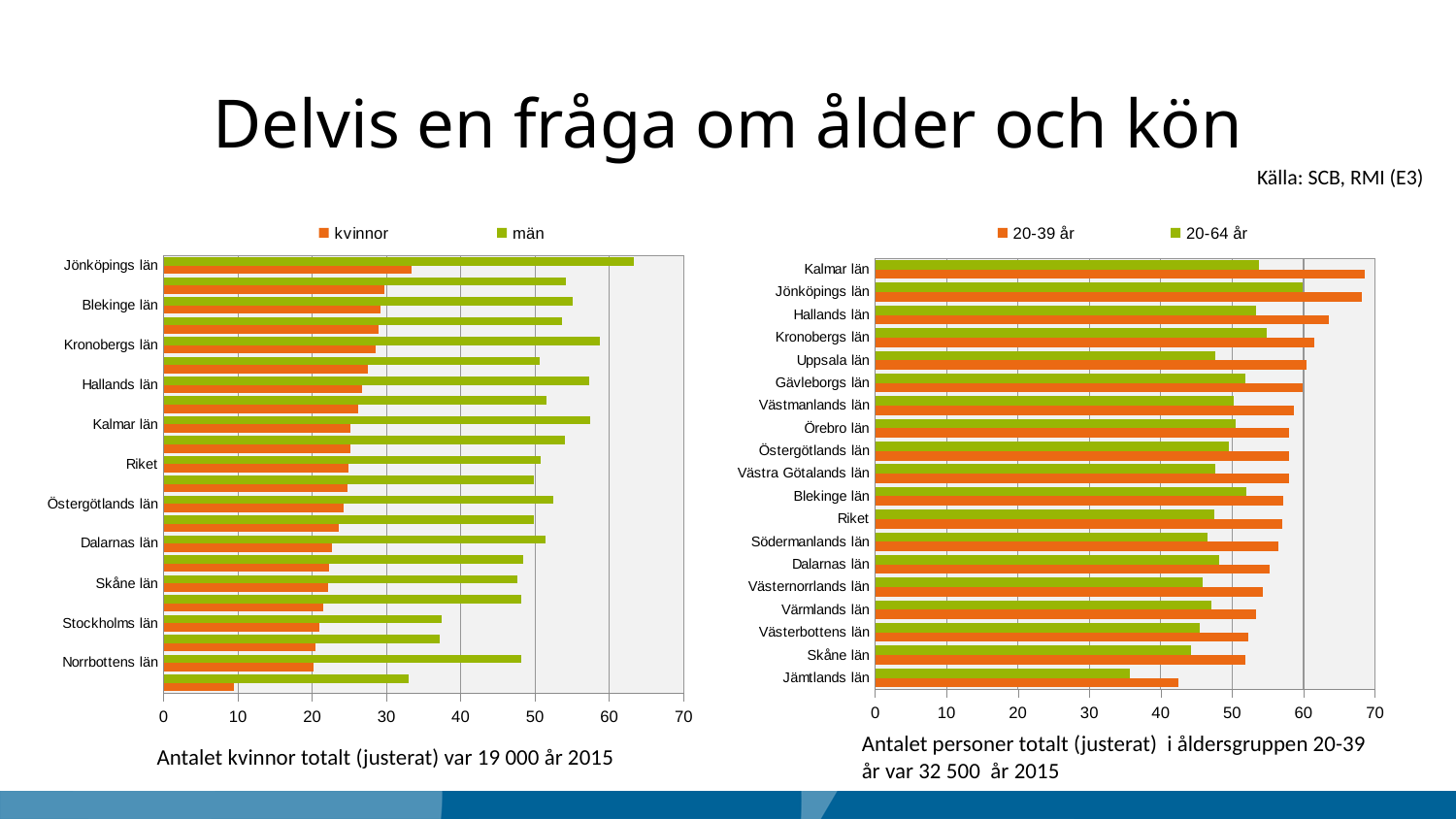
How many series does the legend of the left-hand chart list? 2 In the left-hand chart, which series has the larger value for Jönköpings län, kvinnor or män? män What kind of chart is the right-hand chart (20-39 år / 20-64 år)? bar chart In the right-hand chart, do the 20-39 år values rise or fall going from Kalmar län at the top to Jämtlands län at the bottom? fall In the right-hand chart, which series has the larger value for Kalmar län, 20-39 år or 20-64 år? 20-39 år How many categories (län/Riket) are shown on the right-hand chart? 19 In the left-hand chart, is the män value for Jönköpings län greater or less than 60? greater In the right-hand chart, which category has the lowest 20-64 år value? Jämtlands län In the right-hand chart, which category has the lowest 20-39 år value? Jämtlands län What are the two legend entries of the left-hand chart? kvinnor and män In the right-hand chart, is the 20-64 år value for Jämtlands län greater or less than 40? less In the right-hand chart, is the 20-39 år value for Kalmar län greater or less than 60? greater